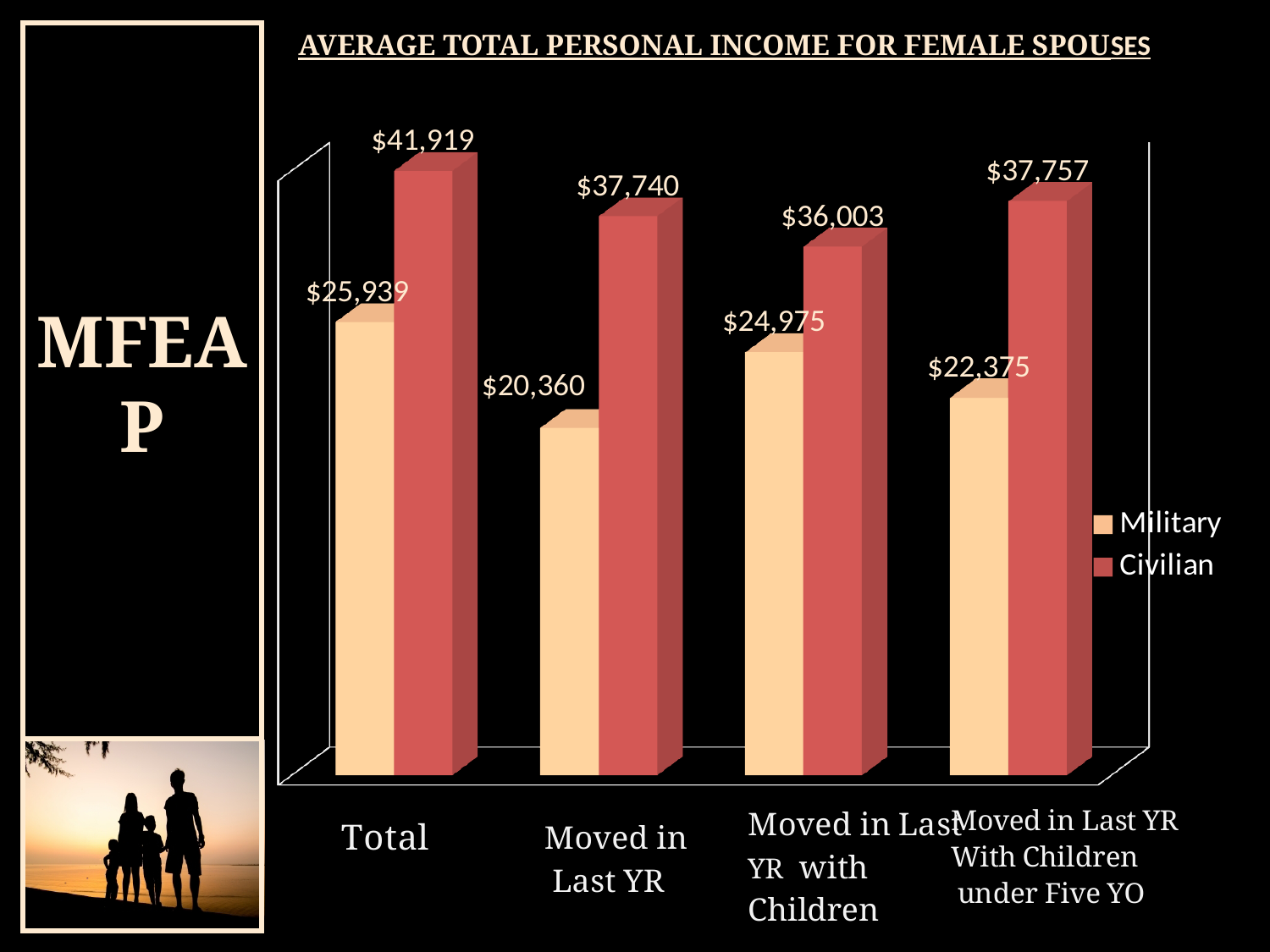
How many series does the legend list? 2 What is the difference between the Civilian and Military values for Total? $15,980 What is the Military value for Total? $25,939 What is the Military value for Moved in Last YR with Children? $24,975 What is the Civilian value for Moved in Last YR With Children under Five YO? $37,757 What is the Civilian value for Moved in Last YR? $37,740 Which is larger for Moved in Last YR with Children, the Military value or the Civilian value? Civilian Which category has the highest Civilian value? Total What is the difference between the Civilian and Military values for Moved in Last YR? $17,380 Which category has the lowest Military value? Moved in Last YR How many categories are shown on the x axis? 4 What kind of chart is shown on the slide? Bar chart